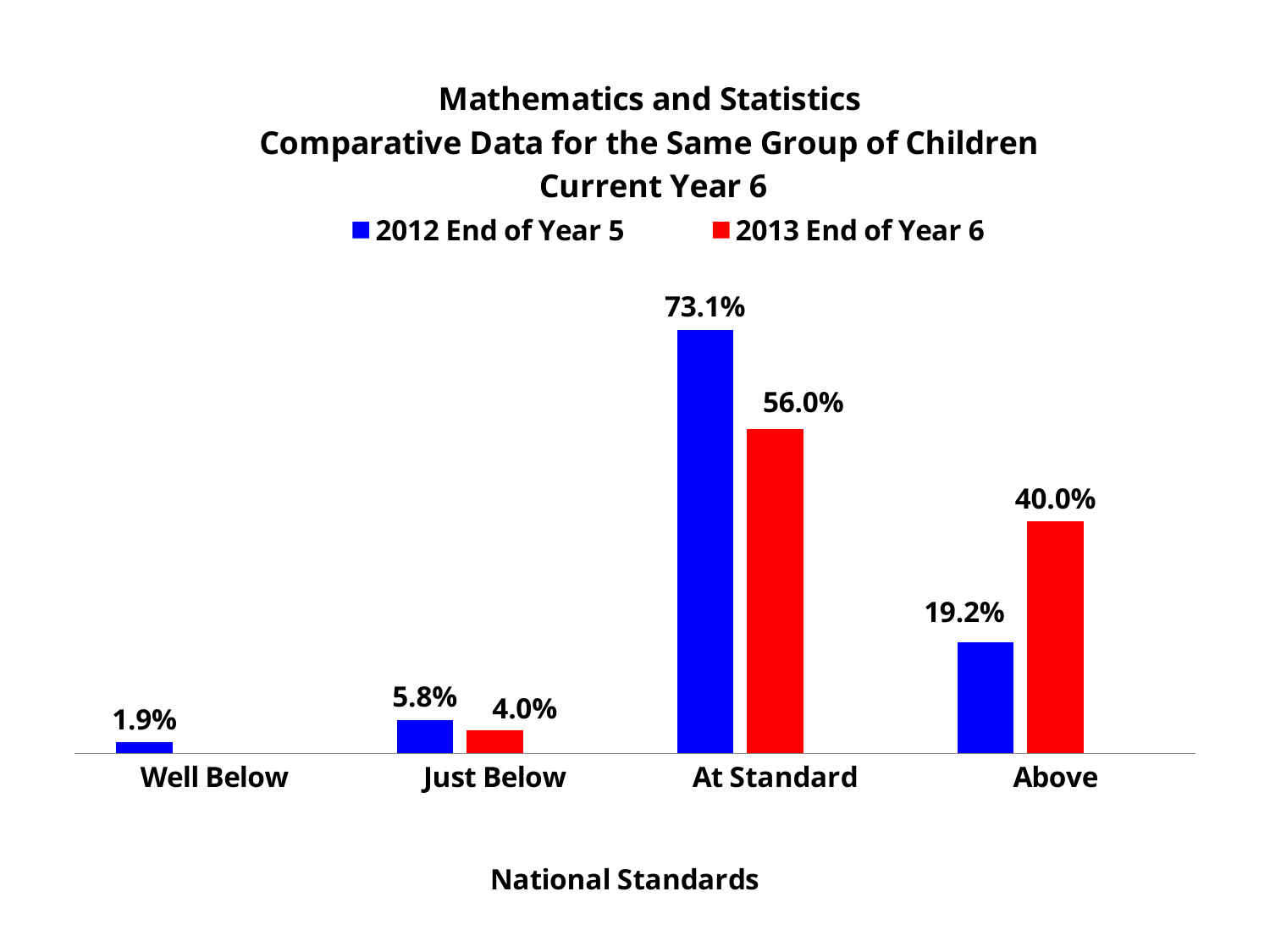
What kind of chart is shown on the slide? Bar chart How many categories are shown on the x axis? 4 What is the value for Just Below in the 2013 End of Year 6 series? 4.0% How many series does the legend list? 2 Which is larger for Just Below: the 2012 End of Year 5 value or the 2013 End of Year 6 value? 2012 End of Year 5 What is the difference between the 2012 End of Year 5 and 2013 End of Year 6 values for At Standard? 17.1% What is the value for Well Below in the 2012 End of Year 5 series? 1.9% Which category has the lowest value in the 2012 End of Year 5 series? Well Below What is the value for Above in the 2013 End of Year 6 series? 40.0% What is the value for At Standard in the 2012 End of Year 5 series? 73.1% Which category has the highest value in the 2013 End of Year 6 series? At Standard What is the difference between the 2013 End of Year 6 and 2012 End of Year 5 values for Above? 20.8%